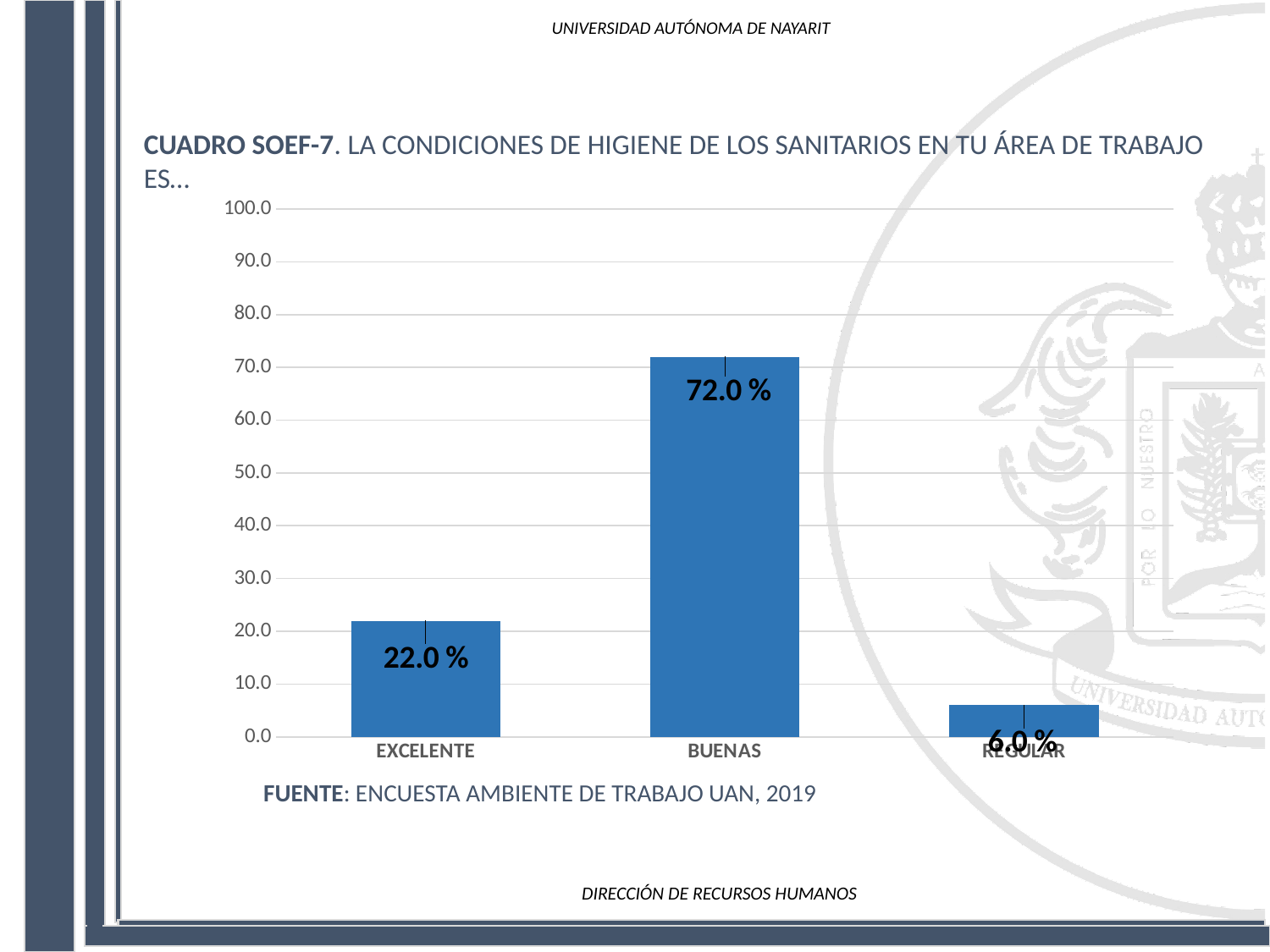
What is the value for EXCELENTE? 22.0 % What source is cited below the chart? ENCUESTA AMBIENTE DE TRABAJO UAN, 2019 Which category has the highest value? BUENAS What kind of chart is shown on the slide? bar chart What is the difference between the values for EXCELENTE and REGULAR? 16.0 % Which category has the lowest value? REGULAR What is the value for BUENAS? 72.0 % What is the value for REGULAR? 6.0 % Is the value for BUENAS greater or less than 70.0? greater How many categories are shown in the chart? 3 Which is larger, the value for EXCELENTE or the value for REGULAR? EXCELENTE What is the difference between the values for BUENAS and EXCELENTE? 50.0 %